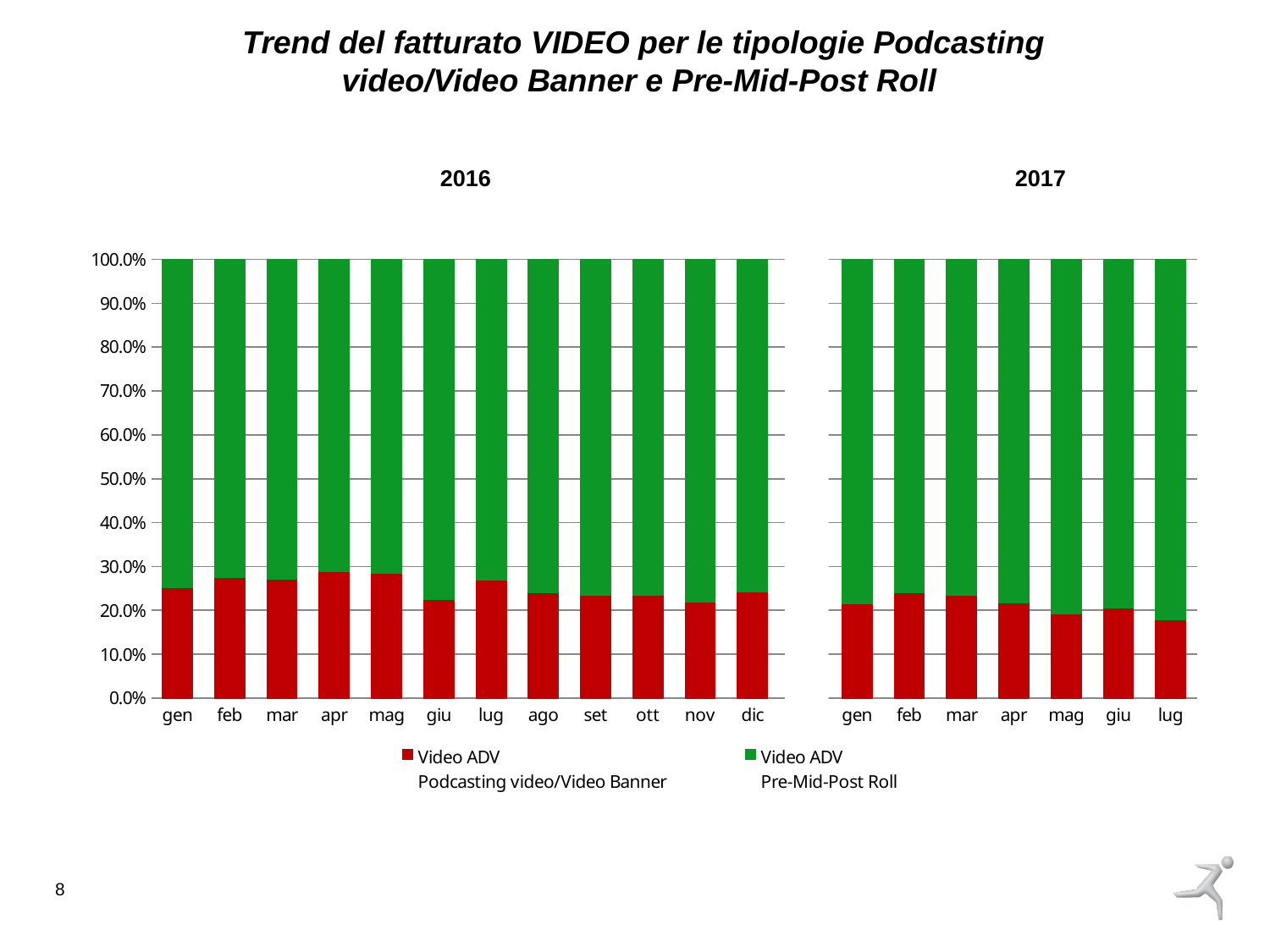
In the 2017 chart, which month has the lowest Video ADV Podcasting video/Video Banner share? lug What kind of chart is shown on the slide? stacked bar chart In the 2017 chart, which has the larger Video ADV Podcasting video/Video Banner share, feb or lug? feb How many series does the legend list? 2 In the 2017 chart, does the Video ADV Podcasting video/Video Banner share generally rise or fall from gen to lug? fall In the 2016 chart, is the Video ADV Podcasting video/Video Banner share for apr greater or less than 20.0%? greater Which colour represents Video ADV Pre-Mid-Post Roll in the legend? green In the 2016 chart, is the Video ADV Podcasting video/Video Banner share for feb greater or less than 30.0%? less In the 2016 chart, which has the larger Video ADV Podcasting video/Video Banner share, apr or giu? apr How many months are plotted in the 2017 chart? 7 How many months are plotted in the 2016 chart? 12 In the 2017 chart, is the Video ADV Podcasting video/Video Banner share for lug greater or less than 20.0%? less